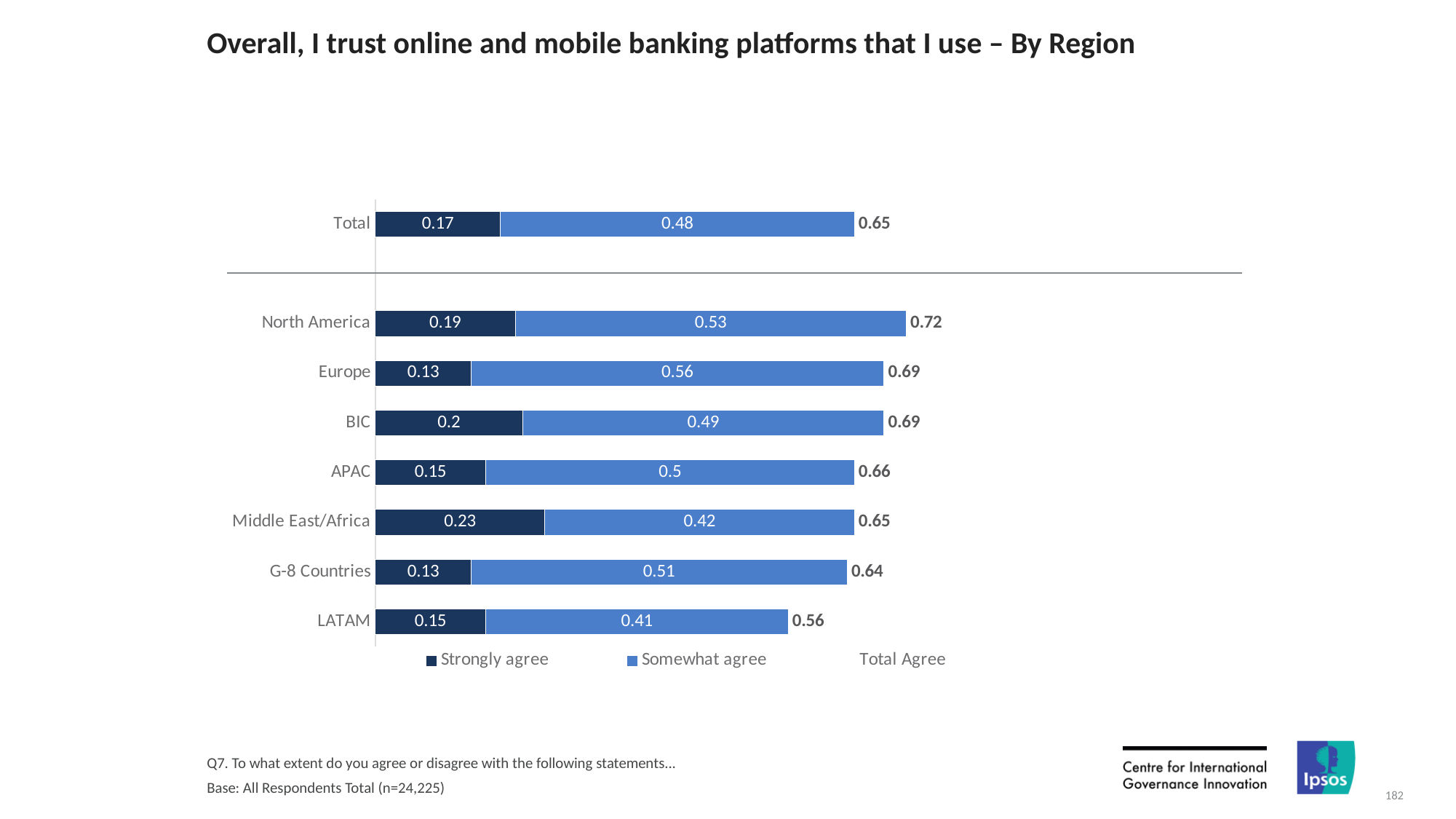
What kind of chart is shown on the slide? Stacked bar chart What is the Somewhat agree value for Europe? 0.56 What is the Total Agree value for LATAM? 0.56 What is the Strongly agree value for North America? 0.19 Which region has the lowest Total Agree value? LATAM Which region has the highest Strongly agree value? Middle East/Africa What is the Total Agree value for the Total row? 0.65 What is the difference between the Total Agree values for North America and LATAM? 0.16 Which is larger, the Somewhat agree value for BIC or for APAC? APAC Which region has the highest Total Agree value? North America How many series does the legend list? 3 How many regions are shown below the Total bar? 7